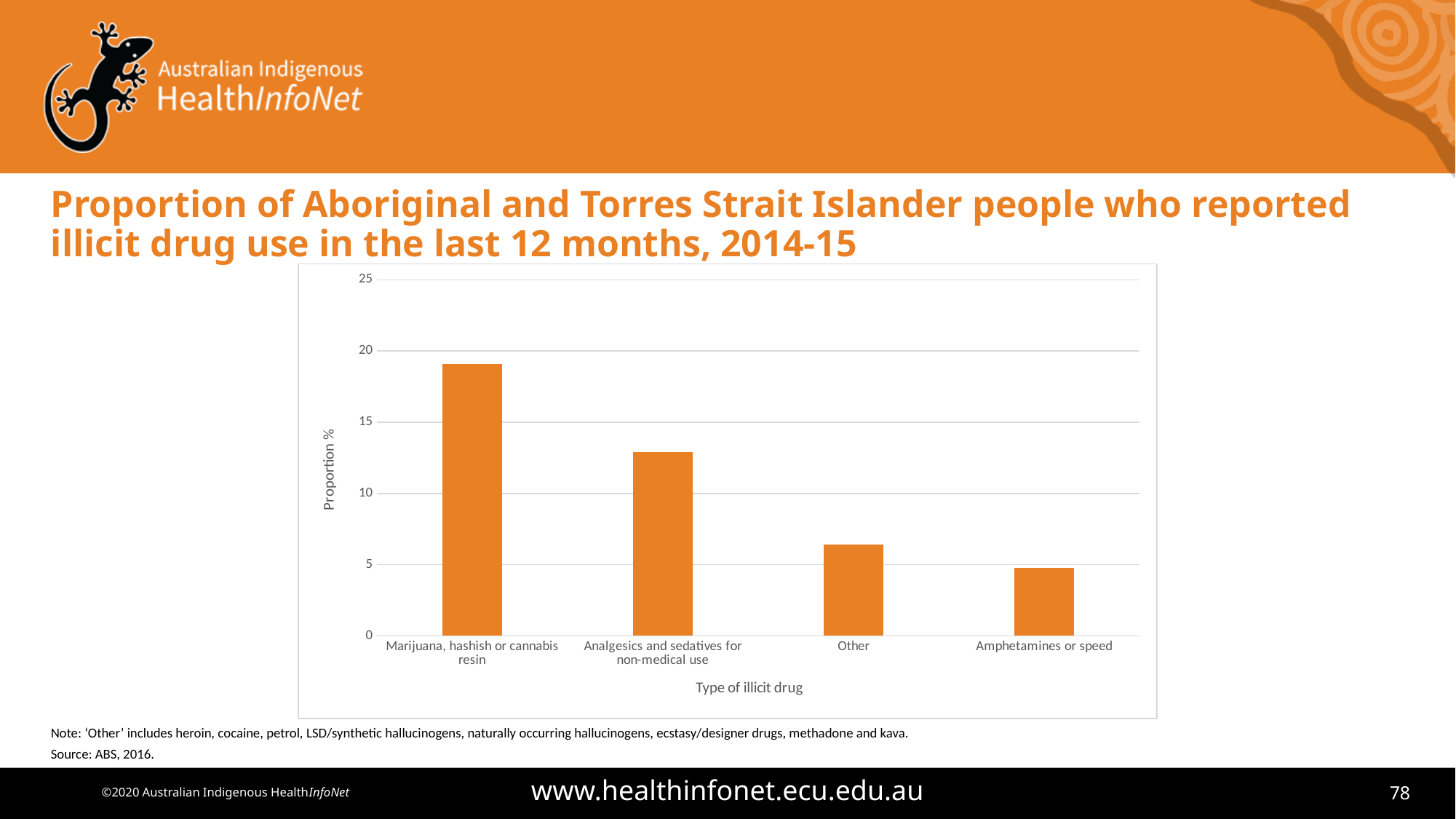
Is the value for Analgesics and sedatives for non-medical use greater or less than 10? greater What kind of chart is shown on the slide? bar chart Which is larger, the value for Other or the value for Amphetamines or speed? Other Is the value for Analgesics and sedatives for non-medical use greater or less than 15? less Is the value for Marijuana, hashish or cannabis resin greater or less than 15? greater Do the values rise or fall moving from left to right along the x axis? fall How many types of illicit drug are shown on the x axis? 4 What is the label of the y axis? Proportion % Which type of illicit drug has the lowest proportion? Amphetamines or speed Which type of illicit drug has the highest proportion? Marijuana, hashish or cannabis resin